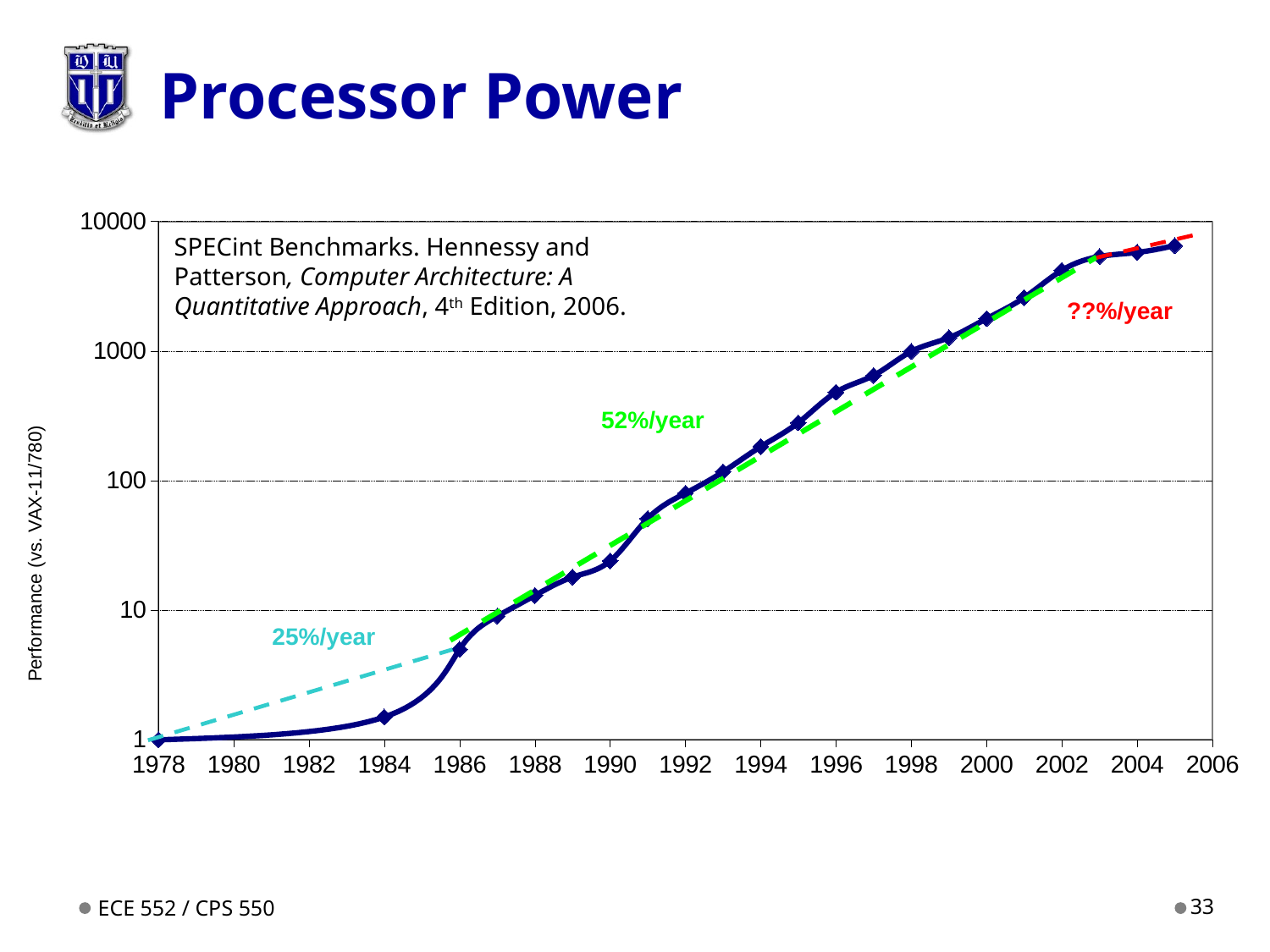
Is the performance value for 1994 greater or less than 100? greater Is the performance value for 1990 greater or less than 10? greater Is the performance value for 2000 greater or less than 1000? greater Which year has the highest plotted performance value? 2005 What annual growth rate is labelled on the green dashed trend line? 52%/year What is the label of the y axis? Performance (vs. VAX-11/780) Do the plotted performance values rise or fall as the year increases along the x axis? rise What kind of chart is shown on the slide? line chart Which year has the larger performance value, 1992 or 2002? 2002 Which year has the lowest plotted performance value? 1978